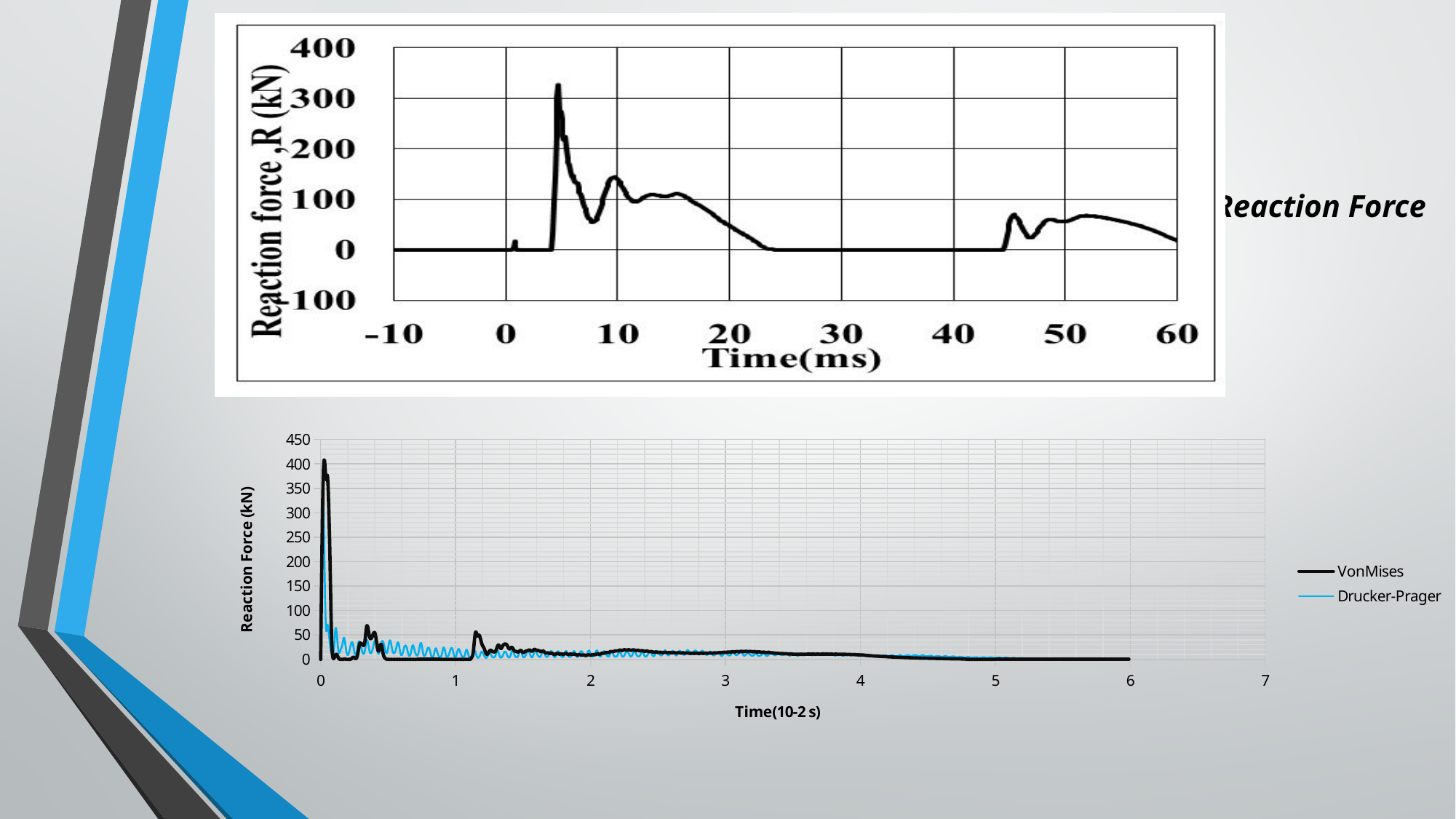
In the top chart, is the peak reaction force greater or less than 300 kN? greater In the bottom chart, how many series does the legend list? 2 In the top chart, is the reaction force at 30 ms greater or less than 100 kN? less What kind of chart is the top chart on the slide? line chart What kind of chart is the bottom chart on the slide? line chart In the top chart, what is the label of the x axis? Time(ms) In the bottom chart, is the VonMises reaction force at time 2 greater or less than 100 kN? less In the bottom chart, what are the names of the two series in the legend? VonMises and Drucker-Prager In the bottom chart, after the initial spike near time 0, do the reaction force values generally rise or fall along the x axis? fall In the bottom chart, which series reaches the higher peak reaction force, VonMises or Drucker-Prager? VonMises